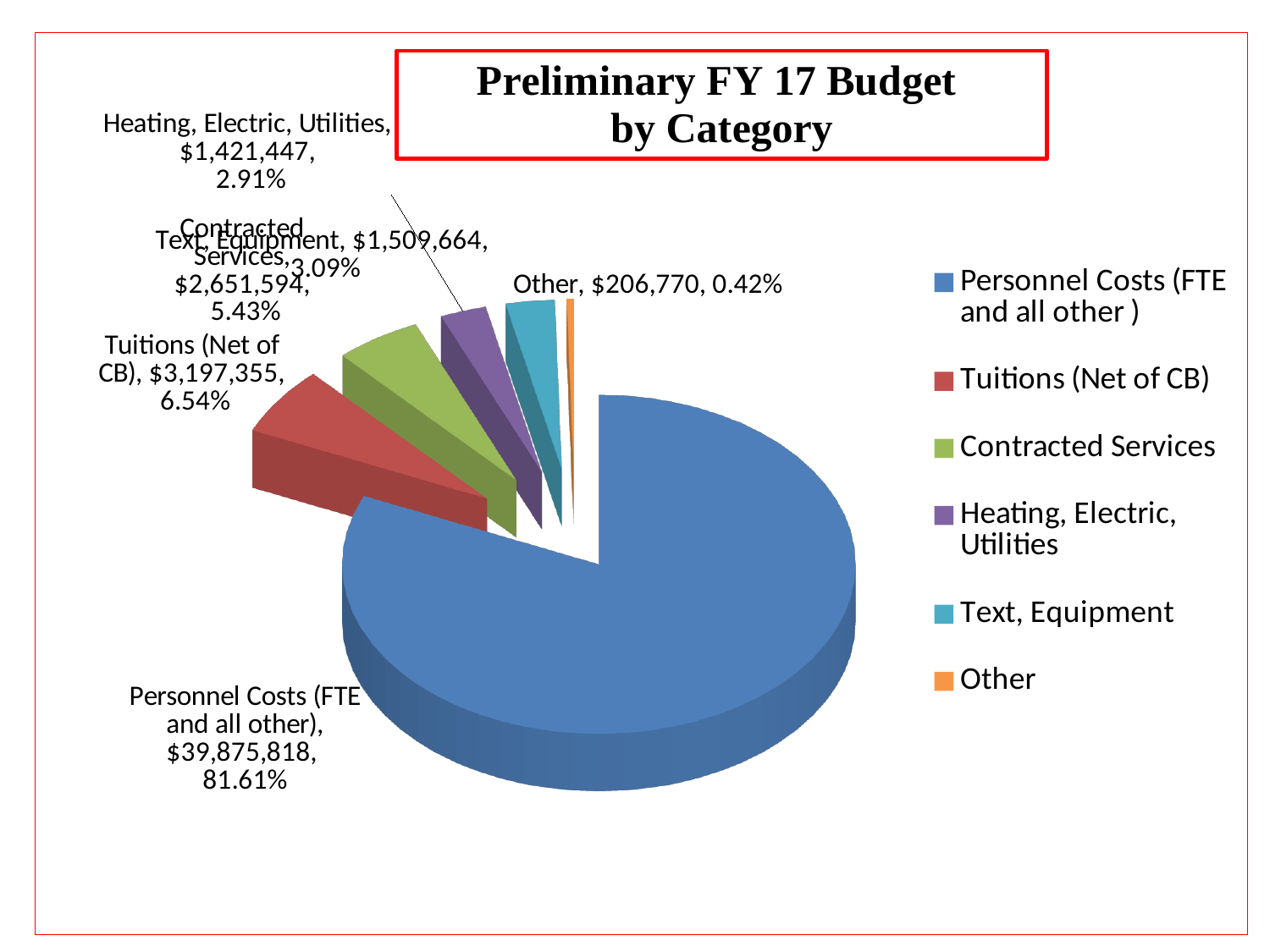
What share of the pie is Heating, Electric, Utilities? 2.91% What share of the pie is Personnel Costs (FTE and all other)? 81.61% What is the value for Other? $206,770 How many categories does the legend list? 6 What is the value for Tuitions (Net of CB)? $3,197,355 Which category has the smallest share of the budget? Other What kind of chart is shown on the slide? Pie chart What share of the pie is Tuitions (Net of CB)? 6.54% What is the title of the chart? Preliminary FY 17 Budget by Category What is the value for Personnel Costs (FTE and all other)? $39,875,818 Which category has the largest share of the budget? Personnel Costs (FTE and all other) Which is larger, Tuitions (Net of CB) or Contracted Services? Tuitions (Net of CB)